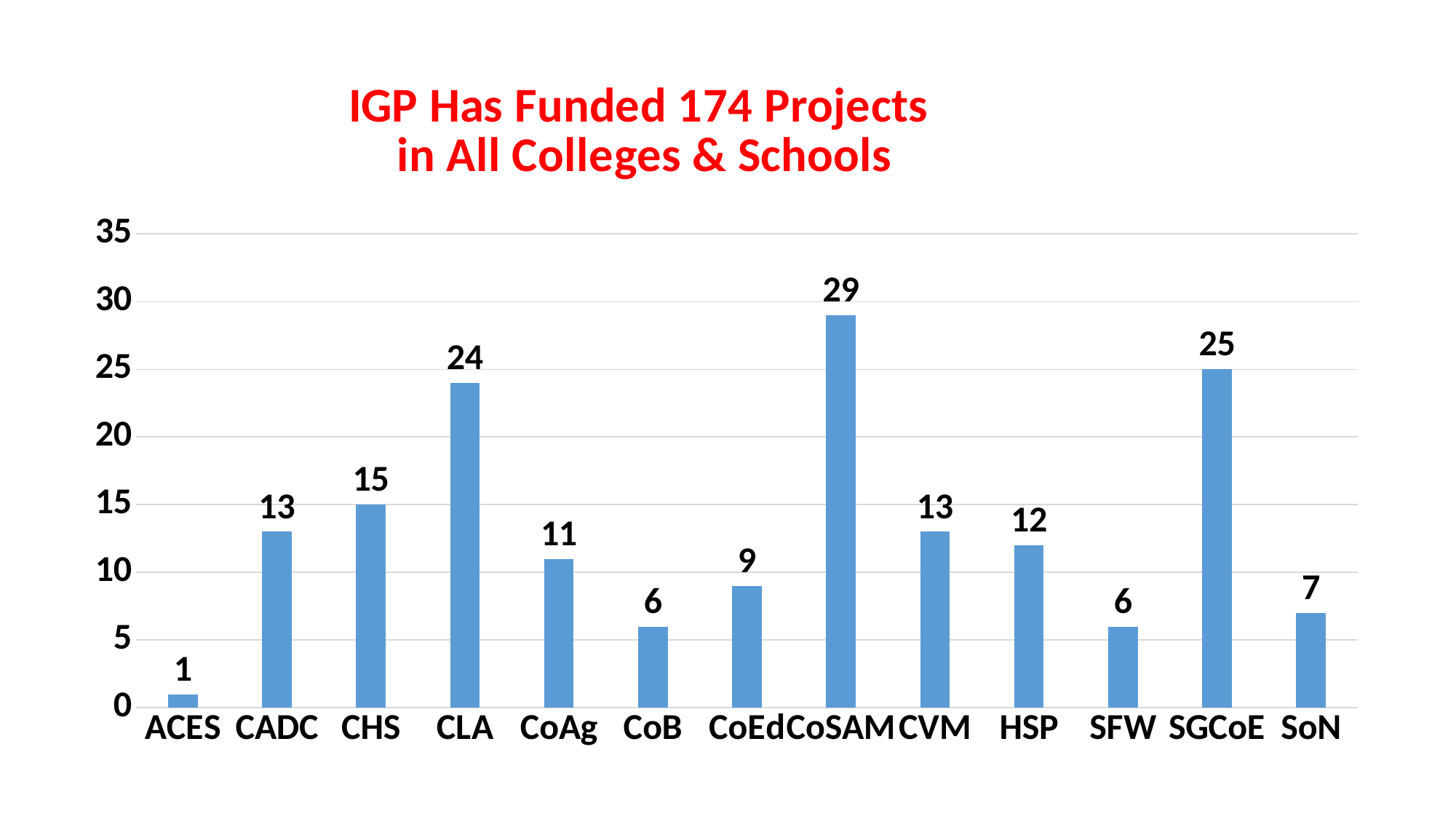
Which college or school has the highest number of funded projects? CoSAM Which has more funded projects, CoAg or HSP? HSP What is the value shown for CLA? 24 What is the title of the chart? IGP Has Funded 174 Projects in All Colleges & Schools How many projects were funded for SoN? 7 What kind of chart is shown on the slide? Bar chart Is the value for SGCoE greater or less than 20? greater What is the difference between the values for CLA and CHS? 9 Which college or school has the lowest number of funded projects? ACES How many colleges and schools are shown on the x axis? 13 What is the difference between the values for CoSAM and SGCoE? 4 How many projects were funded for CoSAM? 29